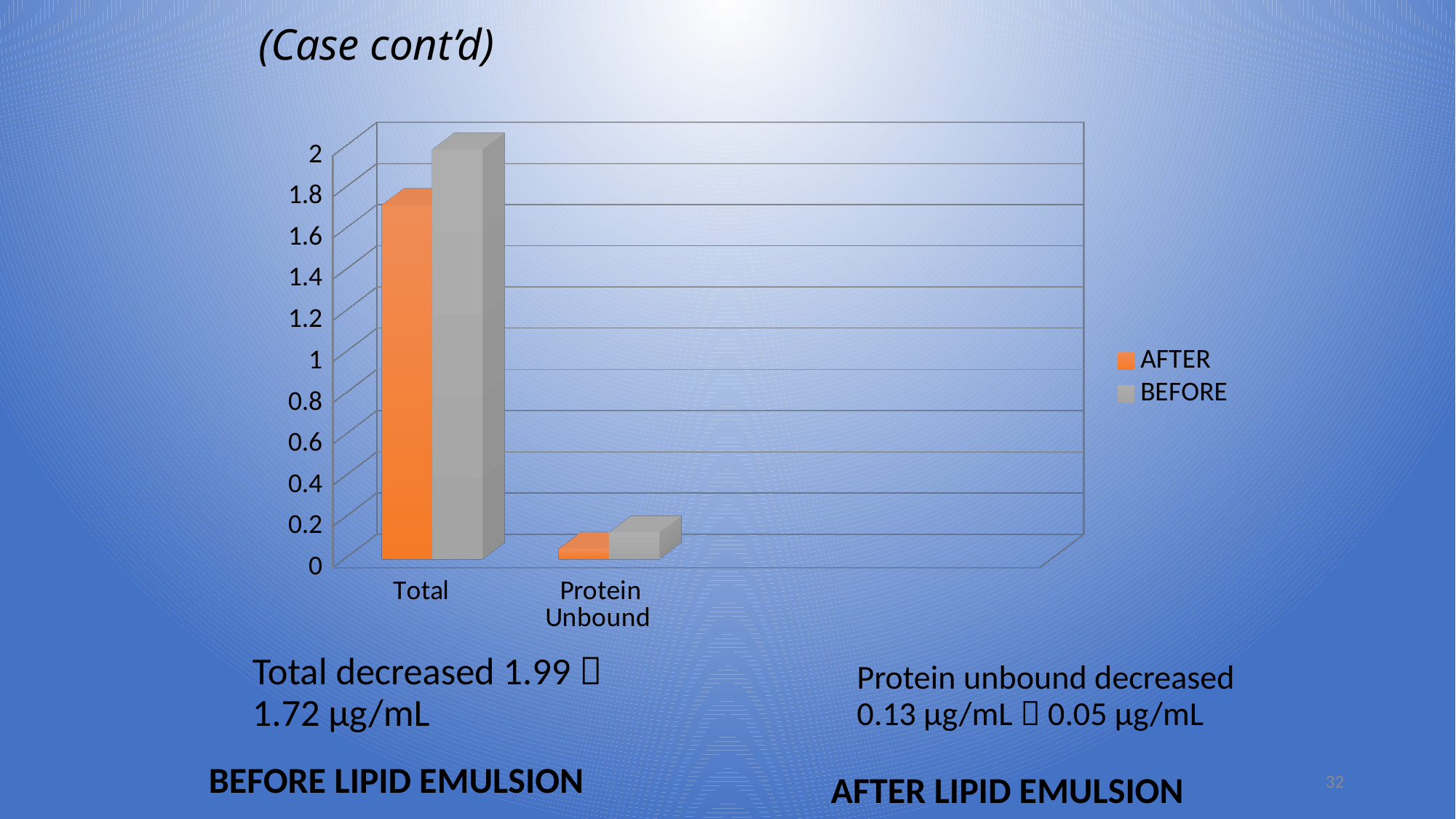
Which series is shown in orange in the chart? AFTER Which category has the highest BEFORE value in the chart? Total Which category has the lowest AFTER value in the chart? Protein Unbound Is the AFTER value for Protein Unbound greater or less than 0.2? less Which series is shown in grey in the chart? BEFORE Is the BEFORE value for Total greater or less than 1.8? greater For the Total category, which is larger, the BEFORE value or the AFTER value? BEFORE According to the slide, what was the Protein Unbound value after lipid emulsion? 0.05 µg/mL How many series does the chart legend list? 2 According to the slide, what was the Total value before lipid emulsion? 1.99 µg/mL How many categories are shown on the x axis of the chart? 2 What kind of chart is shown on the slide? bar chart